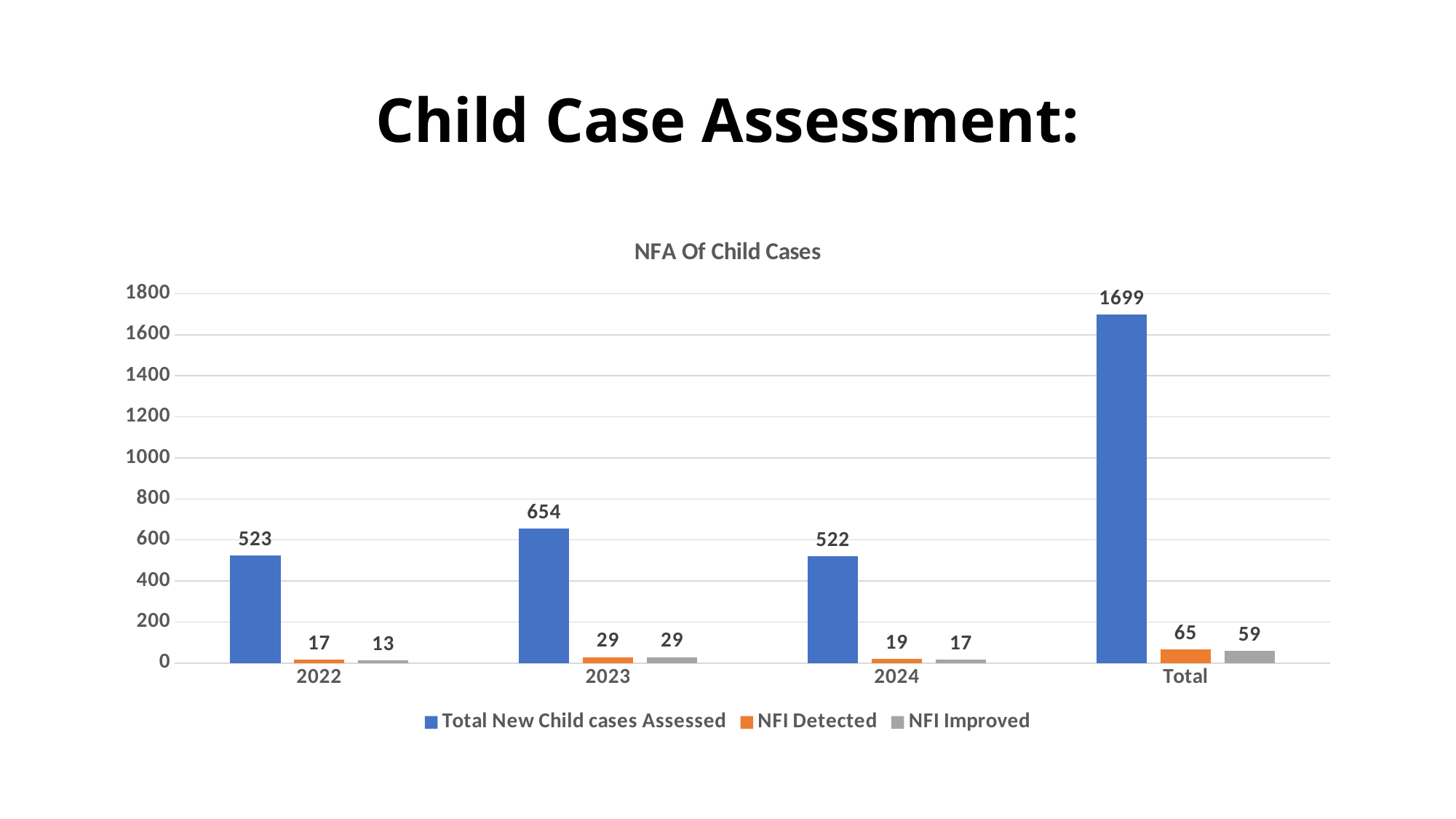
What is the difference between Total New Child cases Assessed in 2023 and in 2022? 131 How many categories are shown on the x axis? 4 Is the Total value for Total New Child cases Assessed greater or less than 1600? greater Among the years 2022, 2023 and 2024, which year has the lowest value for NFI Improved? 2022 What is the Total value for NFI Detected? 65 Which is larger: NFI Detected in 2023 or NFI Detected in 2024? NFI Detected in 2023 What is the value of NFI Detected for 2024? 19 Among the years 2022, 2023 and 2024, which year has the highest value for Total New Child cases Assessed? 2023 What is the value of Total New Child cases Assessed for 2023? 654 What type of chart is shown on the slide? Bar chart How many series does the legend list? 3 What is the value of NFI Improved for 2022? 13